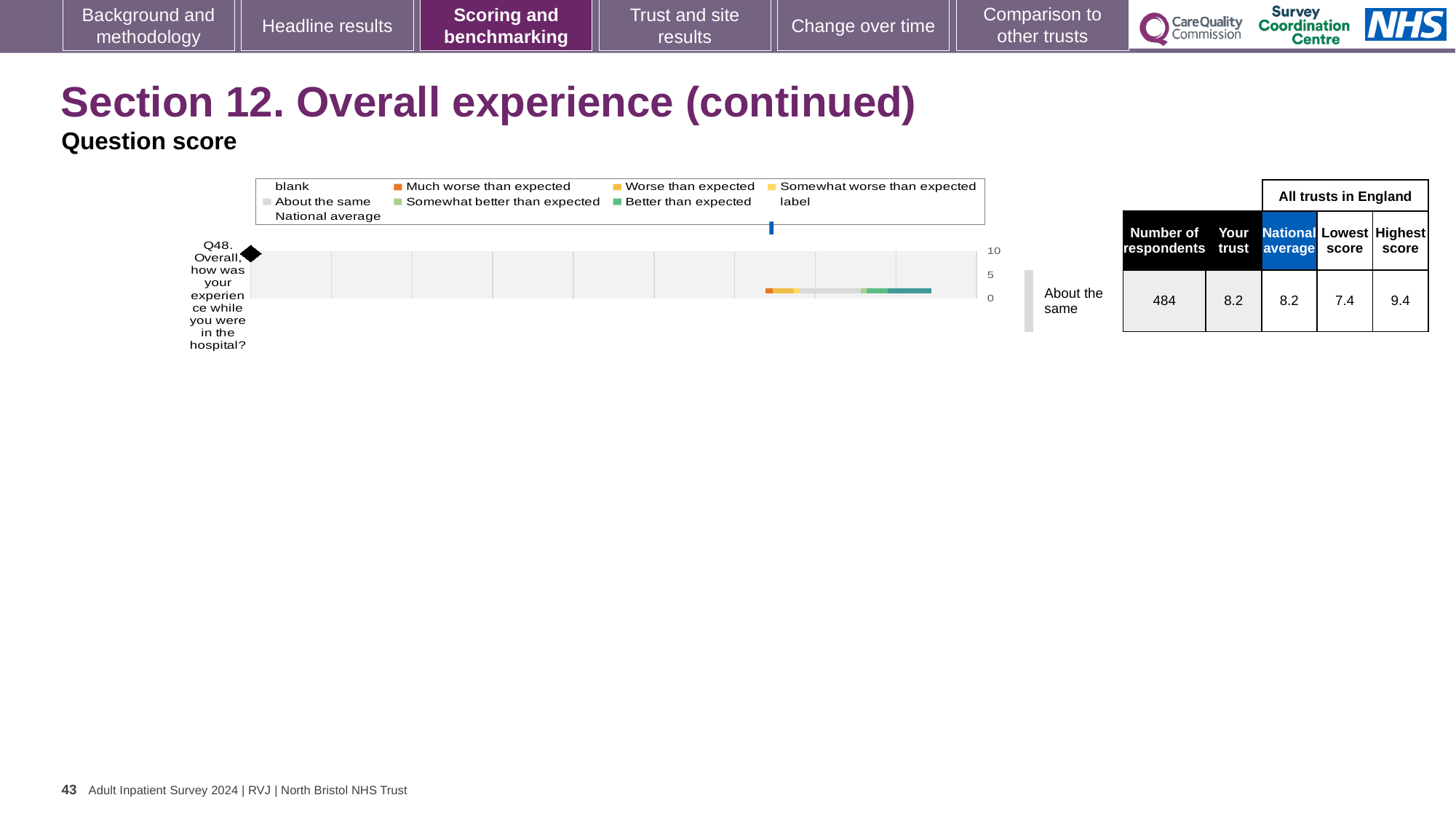
What is the 'Your trust' score for Q48 on this slide? 8.2 What colour represents 'Much worse than expected' in the chart legend? orange What is the lowest score among all trusts in England for Q48? 7.4 How many respondents answered Q48 according to the slide? 484 What is the difference between the highest score and the lowest score for Q48? 2.0 How many survey questions are plotted in the chart on this slide? 1 What is the maximum value shown on the chart's score axis? 10 By how much does the 'Your trust' score for Q48 exceed the lowest score? 0.8 What is the highest score among all trusts in England for Q48? 9.4 What is the national average score for Q48 on this slide? 8.2 What kind of chart is shown for Q48 on this slide? bar chart Which benchmarking category is Q48 assigned to on this slide? About the same